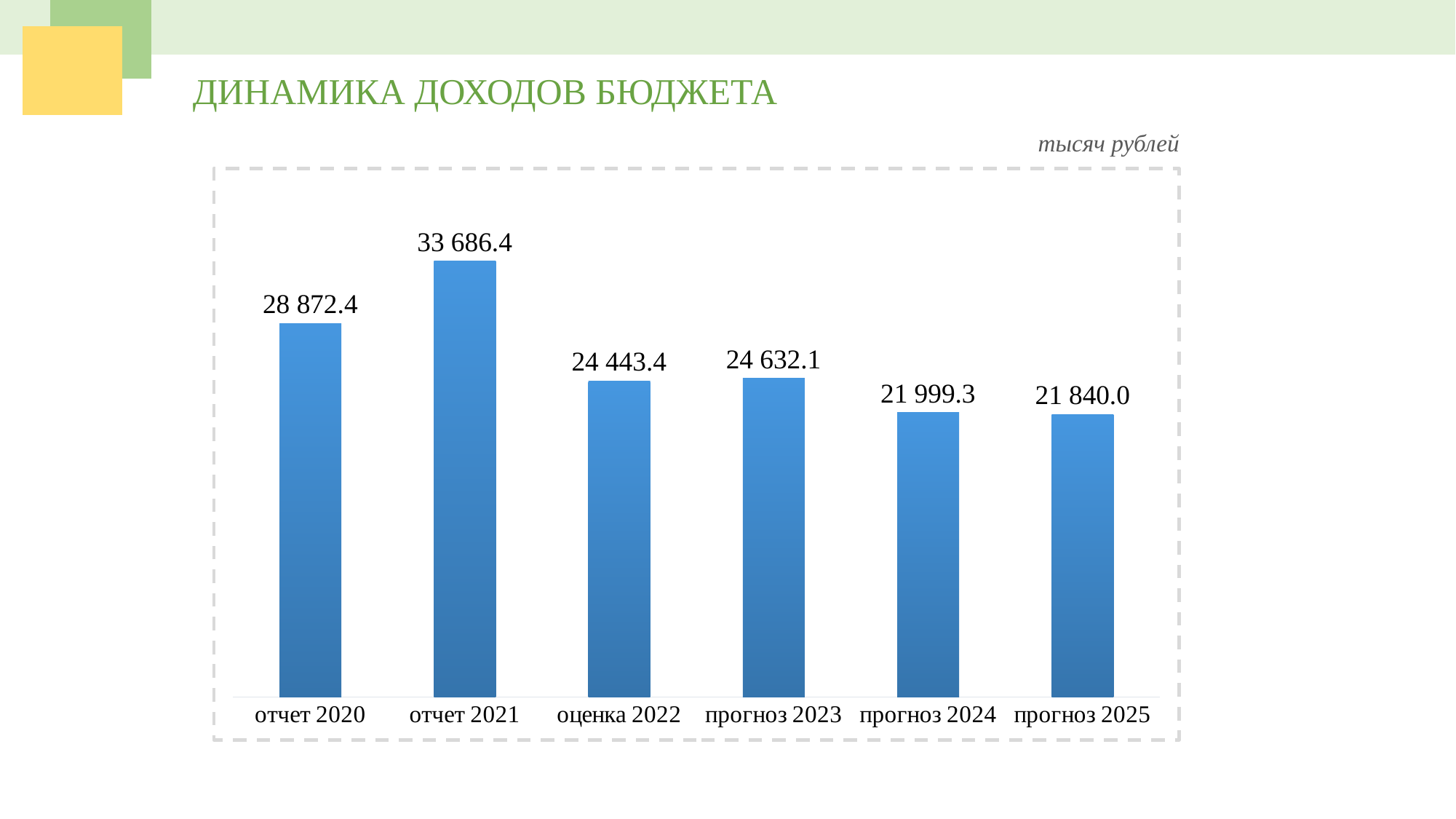
What is the value for прогноз 2024? 21 999.3 How many categories are shown on the chart? 6 Which category has the highest value? отчет 2021 What kind of chart is shown on the slide? bar chart What is the value for оценка 2022? 24 443.4 Which category has the lowest value? прогноз 2025 Which is larger, the value for отчет 2020 or the value for прогноз 2024? отчет 2020 What is the value for отчет 2021? 33 686.4 What is the difference between the values for прогноз 2023 and оценка 2022? 188.7 What is the difference between the values for отчет 2021 and отчет 2020? 4 814.0 From прогноз 2023 to прогноз 2025, do the values rise or fall? fall Which is larger, the value for оценка 2022 or the value for прогноз 2023? прогноз 2023